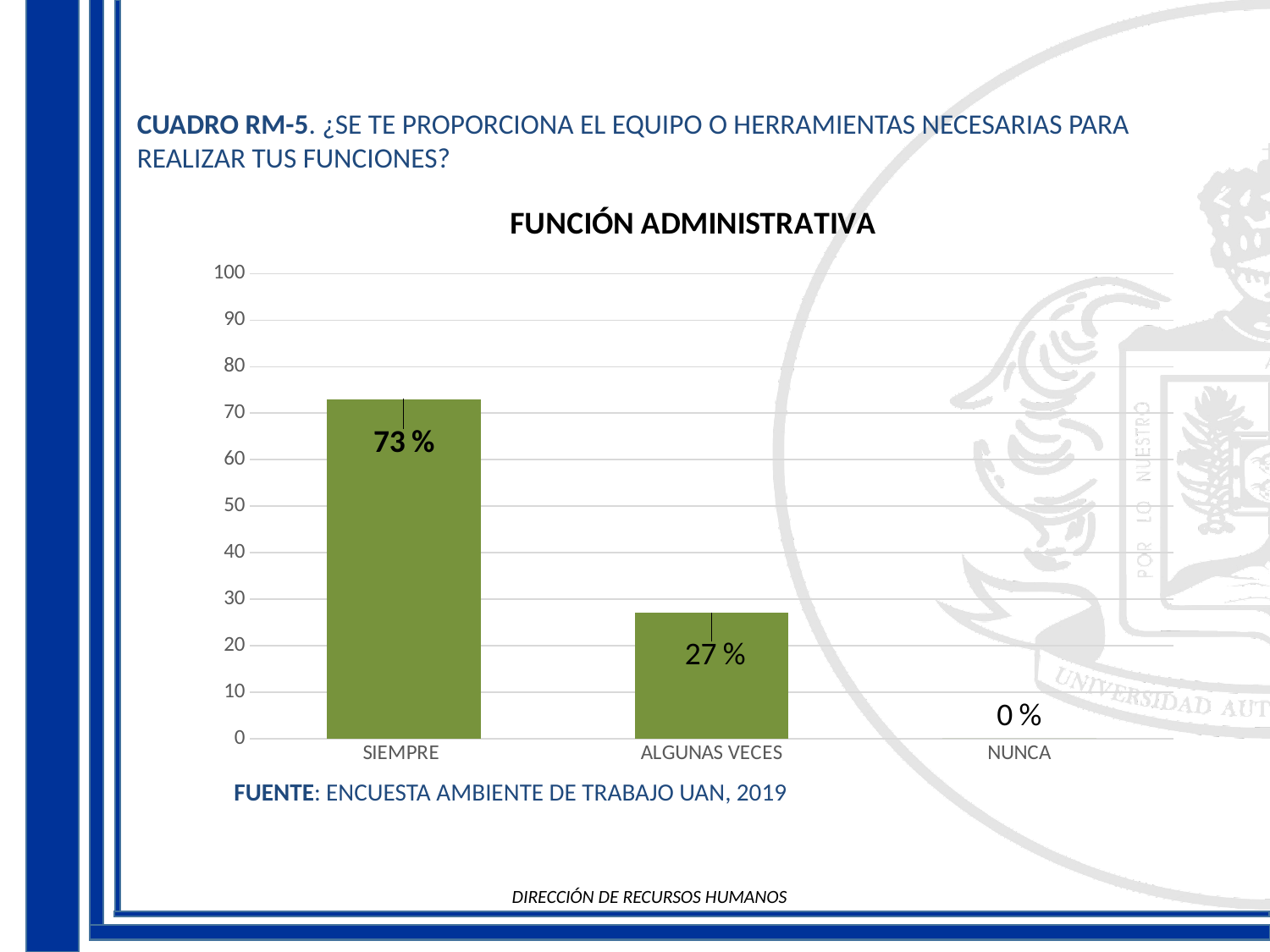
What is the difference between the values for SIEMPRE and ALGUNAS VECES? 46 % What is the value for ALGUNAS VECES? 27 % What is the value for SIEMPRE? 73 % What is the title of the chart? FUNCIÓN ADMINISTRATIVA Which category has the lowest value? NUNCA Which is larger, the value for ALGUNAS VECES or the value for NUNCA? ALGUNAS VECES How many categories are shown on the x axis? 3 What is the value for NUNCA? 0 % What kind of chart is shown? bar chart Is the value for ALGUNAS VECES greater or less than 30? less Which category has the highest value? SIEMPRE Is the value for SIEMPRE greater or less than 50? greater